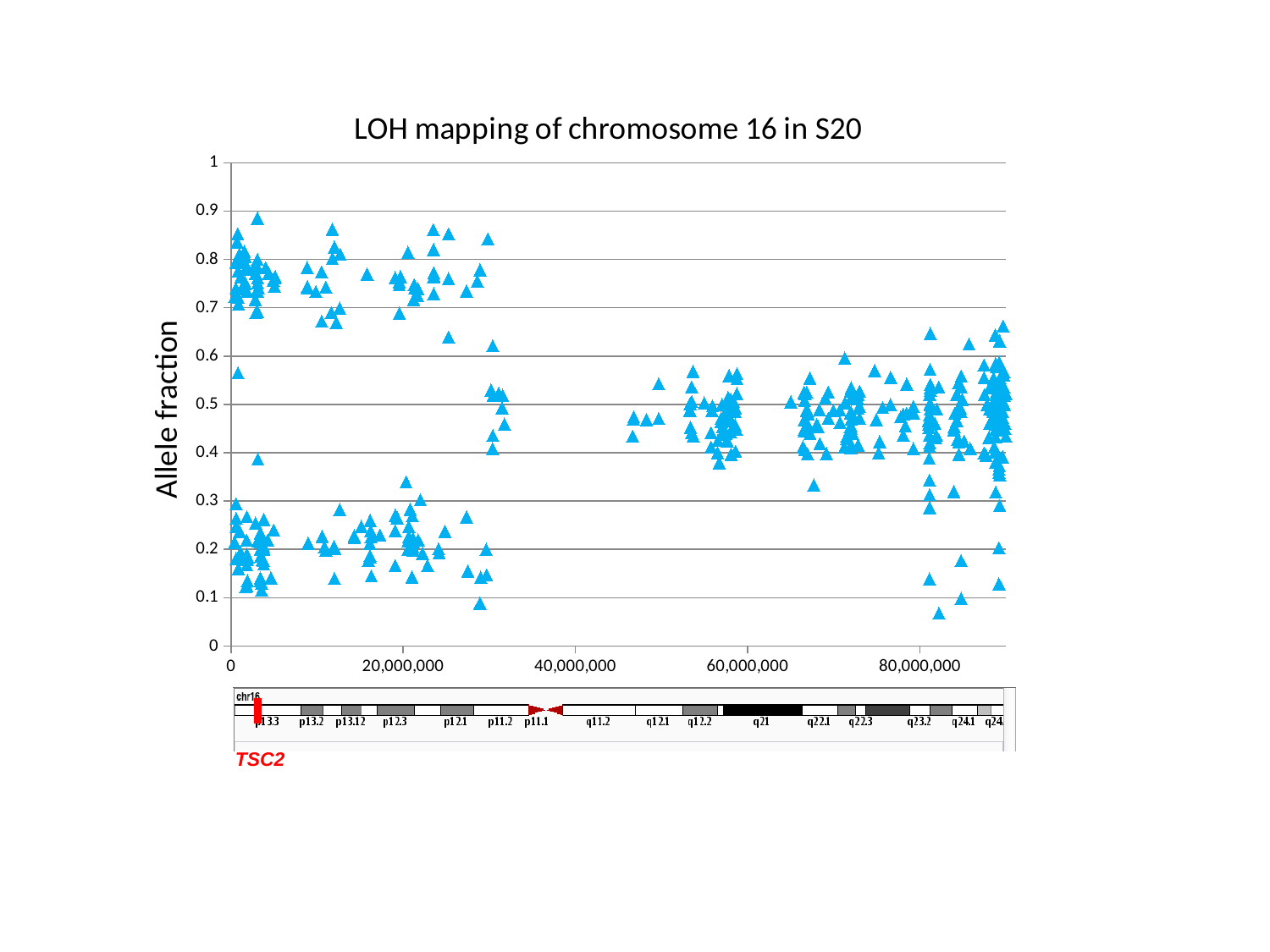
What is the label on the vertical axis of the chart? Allele fraction Is the highest allele fraction plotted between 60,000,000 and 80,000,000 on the x axis greater or less than 0.7? less Is the lowest plotted allele fraction greater or less than 0.1? less Is the highest plotted allele fraction greater or less than 0.8? greater What is the title of the chart? LOH mapping of chromosome 16 in S20 What kind of chart is shown on the slide? scatter plot